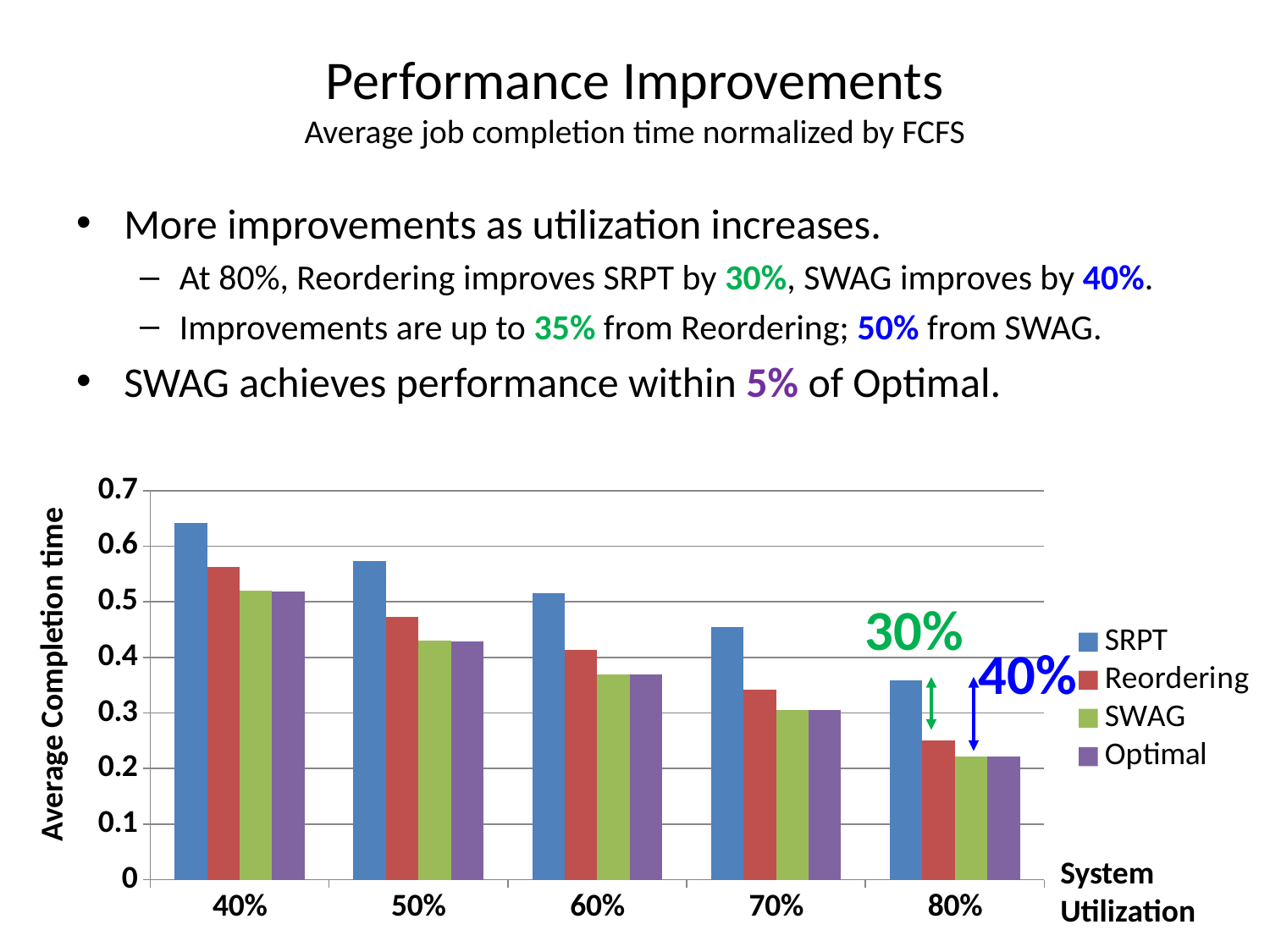
Is the Reordering value at 80% utilization greater or less than 0.3? less At 40% utilization, which is larger: the SRPT bar or the Reordering bar? SRPT Is the SRPT value at 40% utilization greater or less than 0.6? greater Does the SRPT average completion time rise or fall as system utilization increases from 40% to 80%? Fall At which system utilization is the SRPT bar lowest? 80% What kind of chart is shown on the slide? Bar chart What is the label of the chart's horizontal axis? System Utilization At which system utilization is the SRPT bar highest? 40% What is the title of the chart's vertical axis? Average Completion time How many system utilization categories are shown on the x axis? 5 Is the SWAG value at 60% utilization greater or less than 0.4? less How many series does the chart legend list? 4